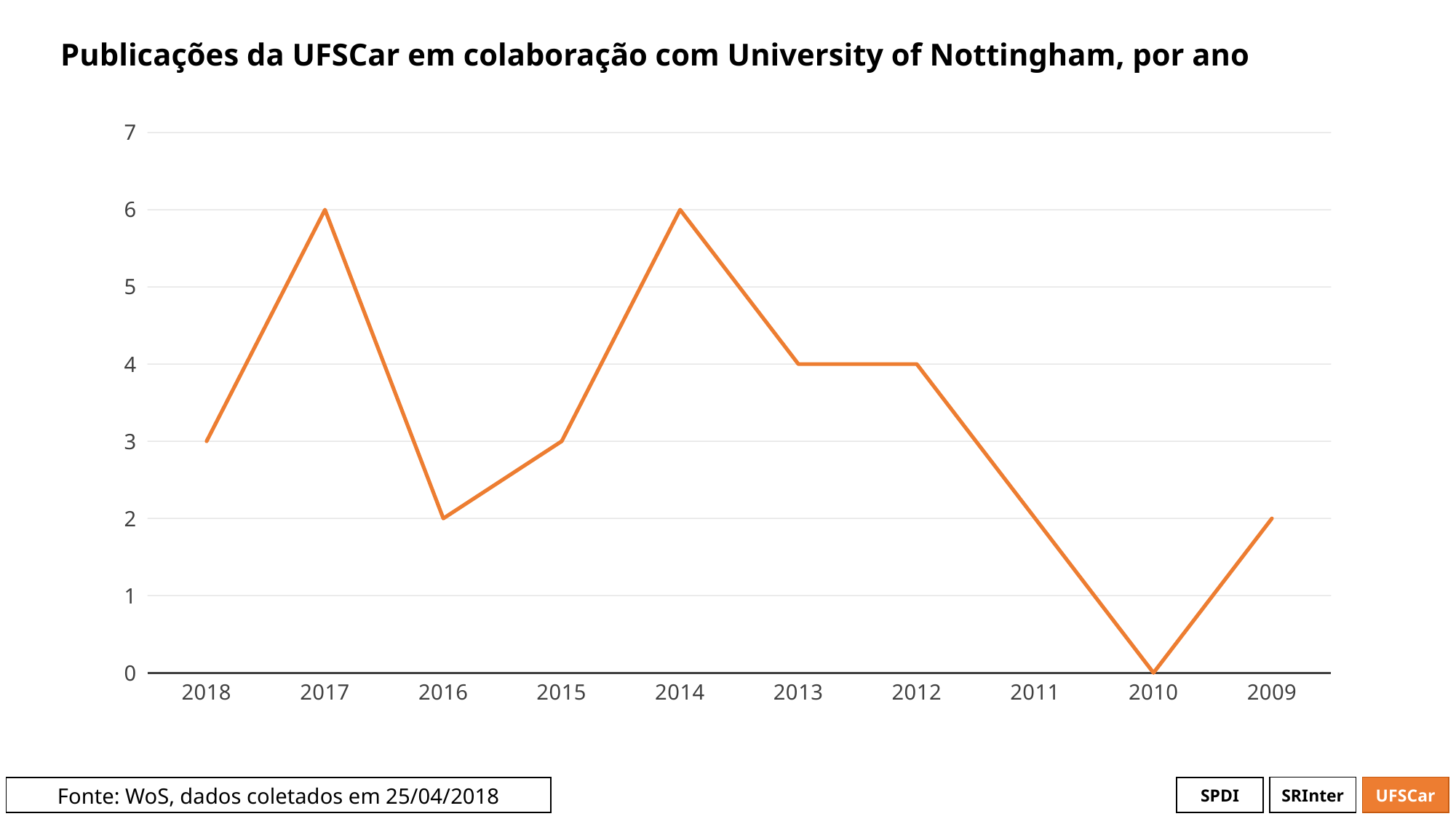
What kind of chart is shown on the slide? line chart What is the value for 2017? 6 What is the value for 2013? 4 What is the value for 2010? 0 How many years are plotted on the x axis? 10 What is the difference between the values for 2014 and 2016? 4 What is the title of the chart? Publicações da UFSCar em colaboração com University of Nottingham, por ano Which is larger, the value for 2012 or the value for 2015? 2012 Is the value for 2017 greater or less than 5? greater Which year has the lowest value? 2010 What is the value for 2009? 2 What is the value for 2018? 3